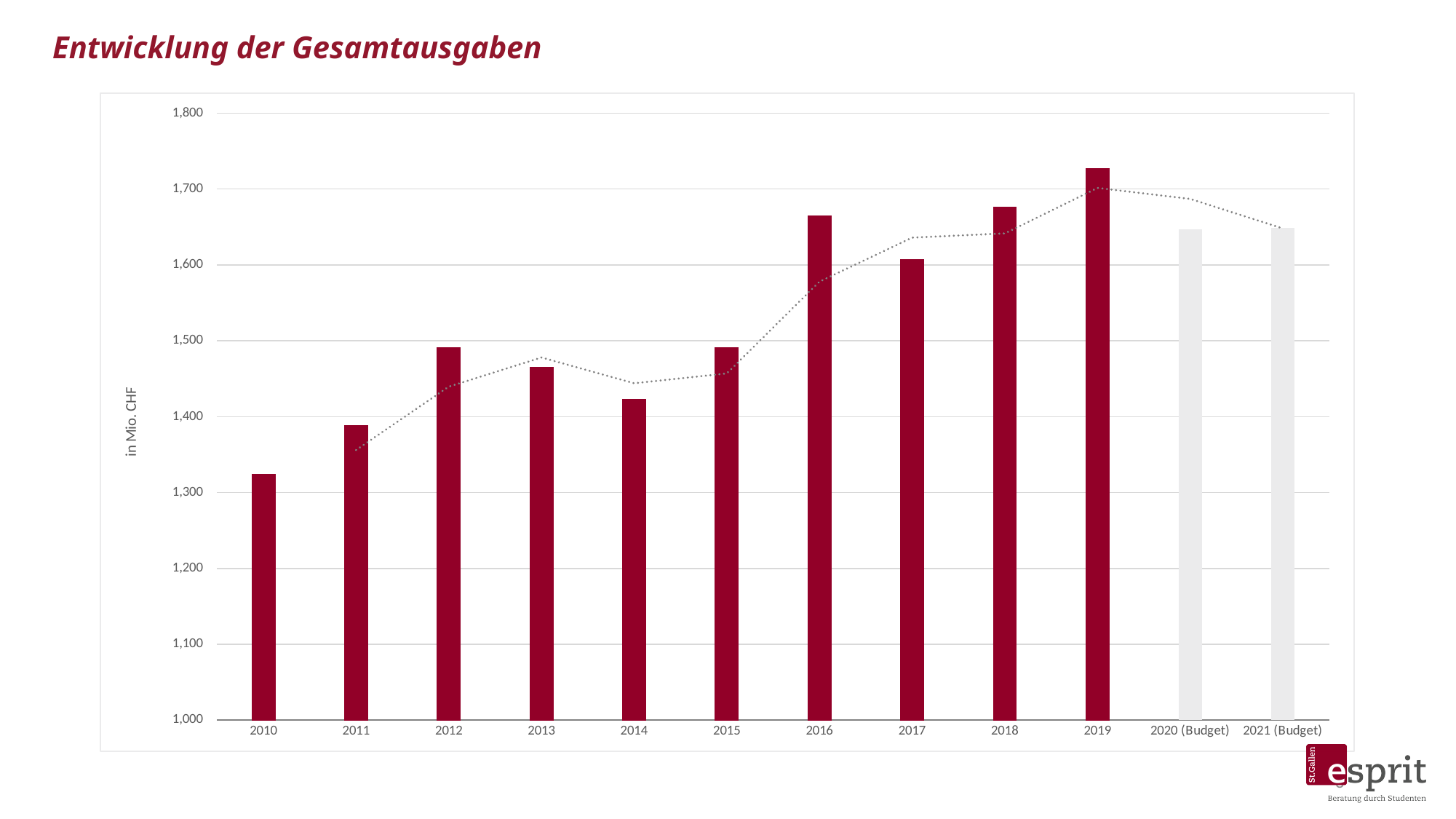
Is the value for 2019 greater or less than 1,700? greater How many categories are shown on the x axis? 12 Is the value for 2016 greater or less than 1,600? greater What kind of chart is shown on the slide? bar chart Which year has the lowest bar? 2010 Is the value for 2010 greater or less than 1,400? less What is the title of the chart? Entwicklung der Gesamtausgaben Which is larger, the value for 2016 or the value for 2017? 2016 Which year has the highest bar? 2019 What is the label on the vertical axis? in Mio. CHF Do the values generally rise or fall from 2010 to 2019? rise